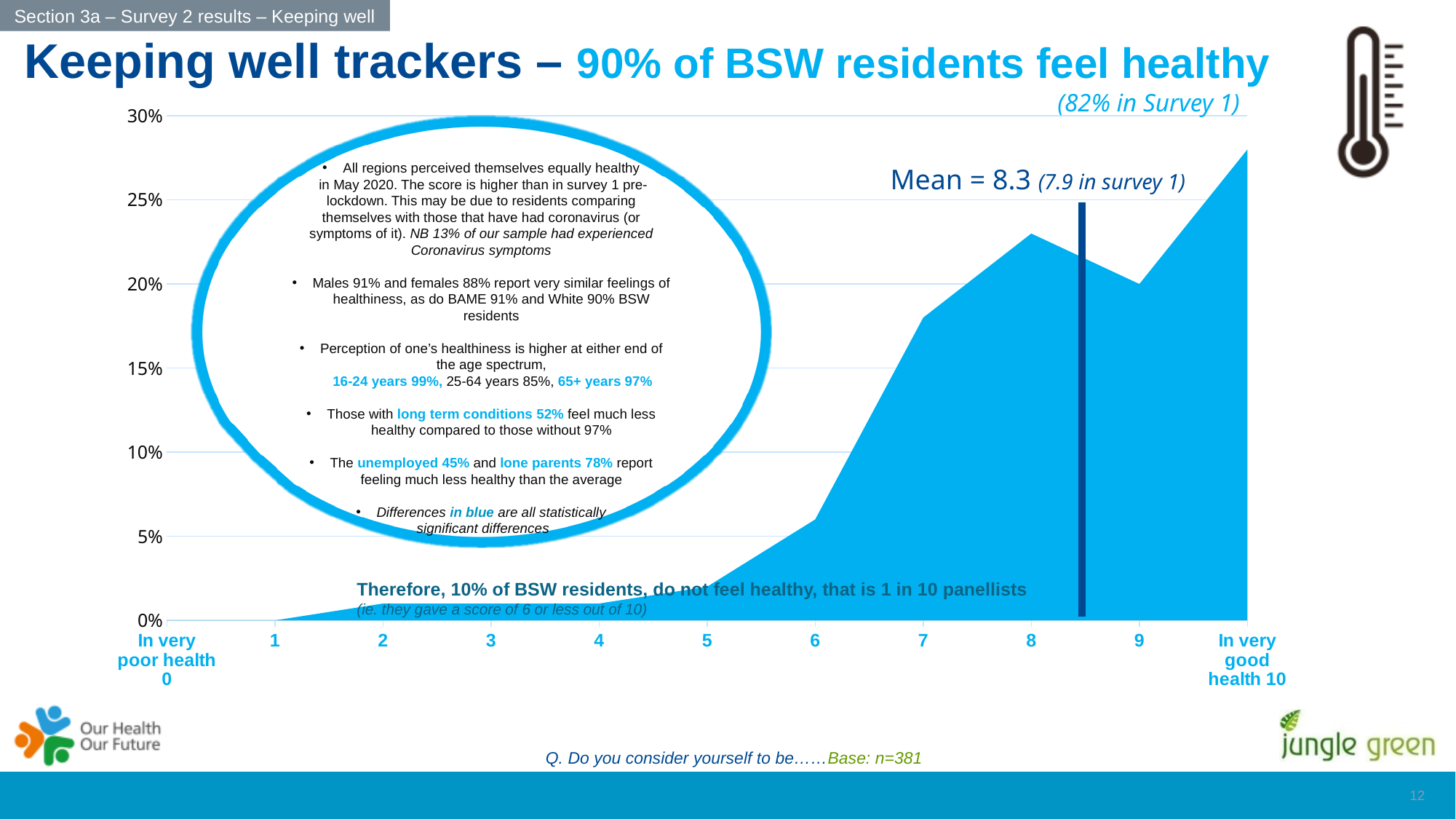
Is the value for score 10 (In very good health) greater or less than 25%? greater Do the values rise or fall from score 6 to score 8? Rise Is the value for score 8 greater or less than 20%? greater Is the value for score 9 greater or less than 25%? less What was the mean score in survey 1, as noted on the chart? 7.9 Which has the larger value, score 8 or score 9? Score 8 What kind of chart is shown on the slide? Area chart What mean score is annotated on the chart for this survey? 8.3 How many score categories are shown along the x axis of the chart? 11 Which score on the x axis has the highest percentage of residents? In very good health 10